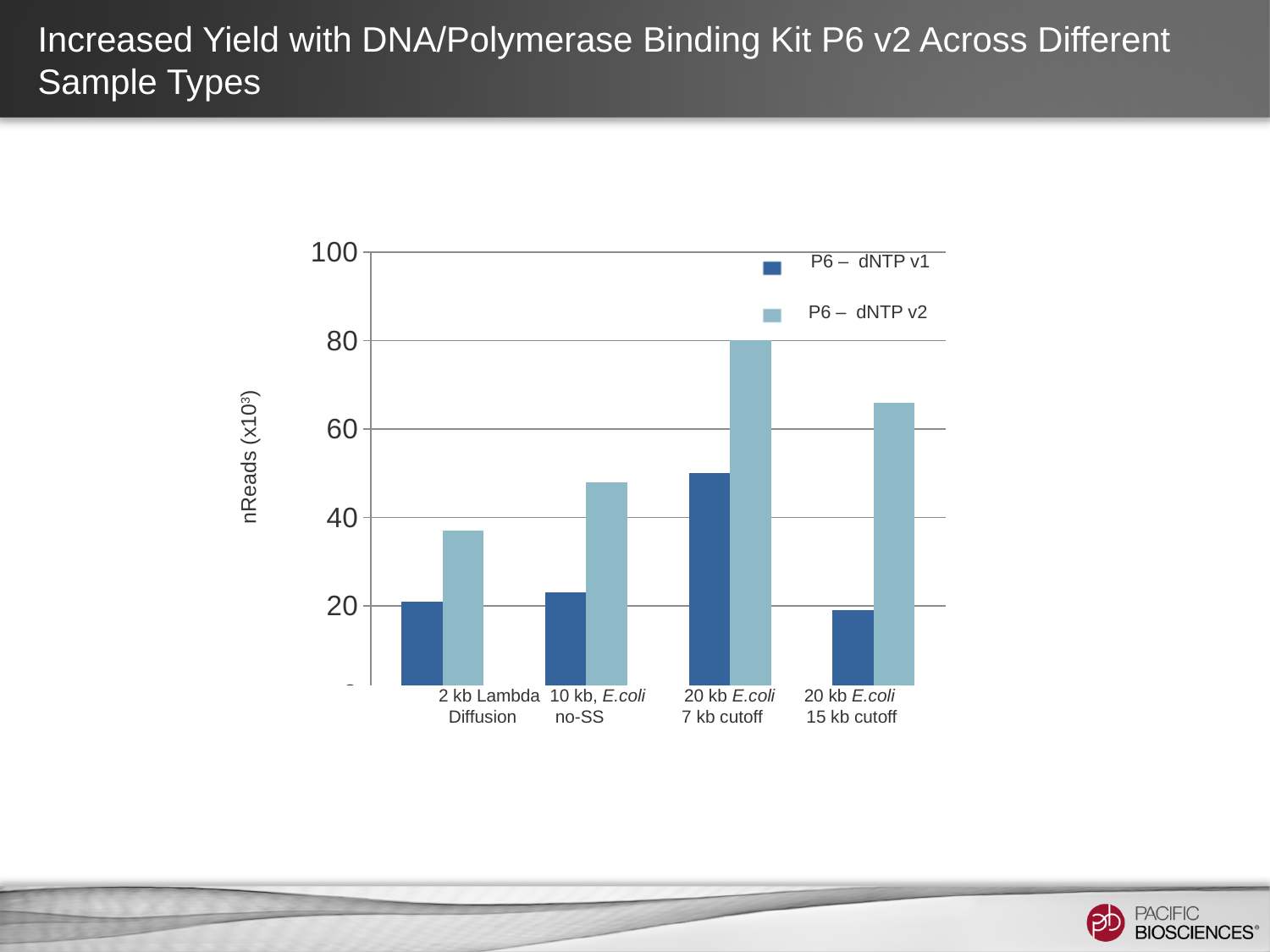
Which sample type has the highest P6 – dNTP v2 value? 20 kb E.coli 7 kb cutoff How many sample types (categories) are shown on the x axis? 4 What kind of chart is shown on the slide? bar chart How many series does the legend list? 2 Which sample type has the lowest P6 – dNTP v2 value? 2 kb Lambda Diffusion Which sample type has the highest P6 – dNTP v1 value? 20 kb E.coli 7 kb cutoff What is the label on the y axis of the chart? nReads (x10³) Is the P6 – dNTP v2 value for 20 kb E.coli 15 kb cutoff greater or less than 60? greater For P6 – dNTP v2, which is larger: 10 kb E.coli no-SS or 20 kb E.coli 15 kb cutoff? 20 kb E.coli 15 kb cutoff Is the P6 – dNTP v1 value for 20 kb E.coli 7 kb cutoff greater or less than 40? greater For 20 kb E.coli 7 kb cutoff, which series has the larger value, P6 – dNTP v1 or P6 – dNTP v2? P6 – dNTP v2 Is the P6 – dNTP v2 value for 10 kb E.coli no-SS greater or less than 60? less